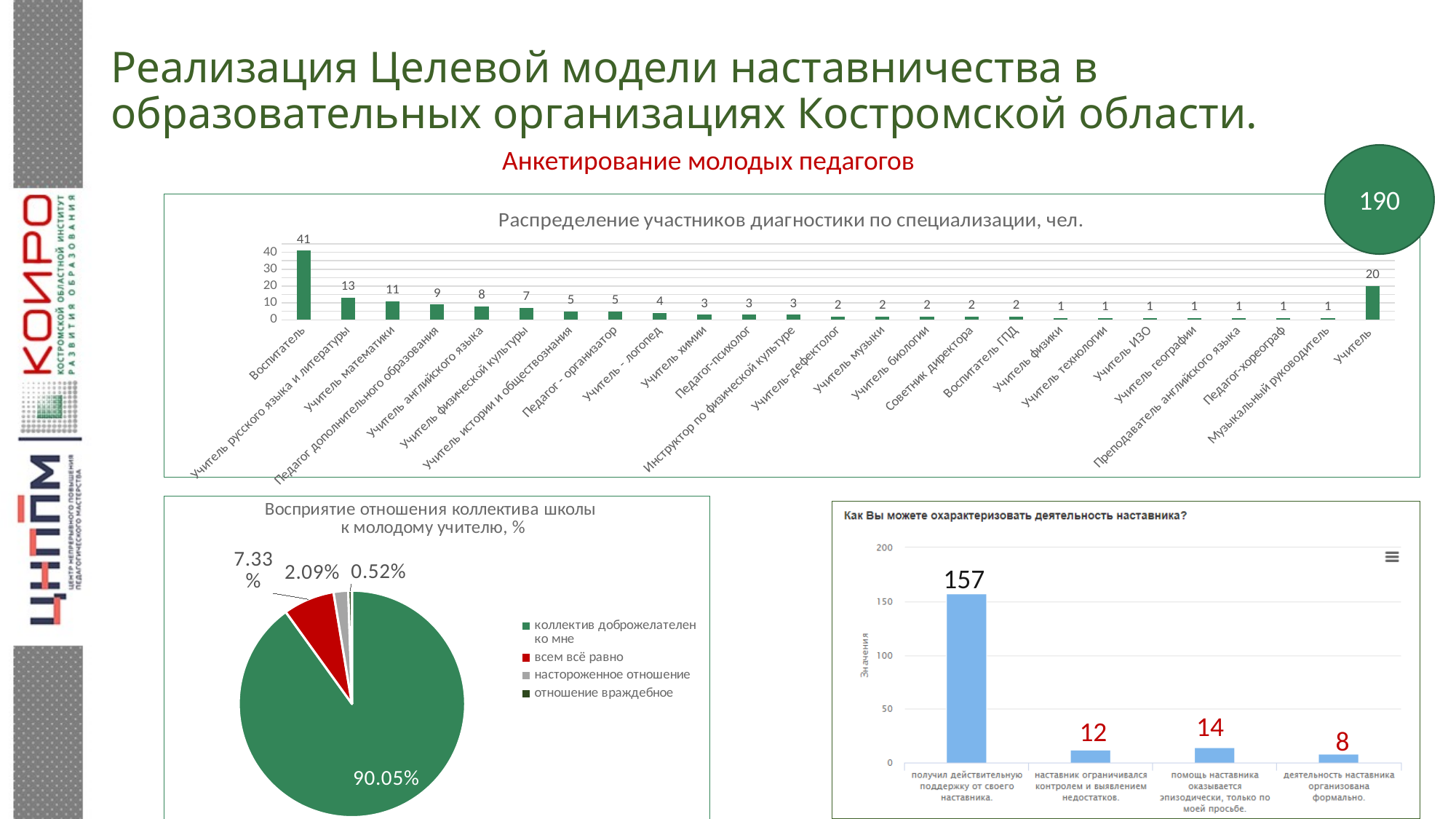
In the chart 'Распределение участников диагностики по специализации, чел.', what is the difference between the values for Воспитатель and Учитель? 21 What kind of chart is 'Восприятие отношения коллектива школы к молодому учителю, %'? pie chart In the chart 'Распределение участников диагностики по специализации, чел.', what is the value for Воспитатель? 41 How many categories are shown in the chart 'Как Вы можете охарактеризовать деятельность наставника?'? 4 In the chart 'Распределение участников диагностики по специализации, чел.', which is larger: Учитель русского языка и литературы or Учитель английского языка? Учитель русского языка и литературы In the chart 'Распределение участников диагностики по специализации, чел.', what is the value for Учитель математики? 11 In the chart 'Восприятие отношения коллектива школы к молодому учителю, %', what share does 'коллектив доброжелателен ко мне' have? 90.05% How many entries does the legend of the chart 'Восприятие отношения коллектива школы к молодому учителю, %' list? 4 In the chart 'Распределение участников диагностики по специализации, чел.', which category has the highest value? Воспитатель In the chart 'Восприятие отношения коллектива школы к молодому учителю, %', what share does 'всем всё равно' have? 7.33% In the chart 'Как Вы можете охарактеризовать деятельность наставника?', what is the value for 'получил действительную поддержку от своего наставника'? 157 In the chart 'Как Вы можете охарактеризовать деятельность наставника?', which category has the lowest value? деятельность наставника организована формально